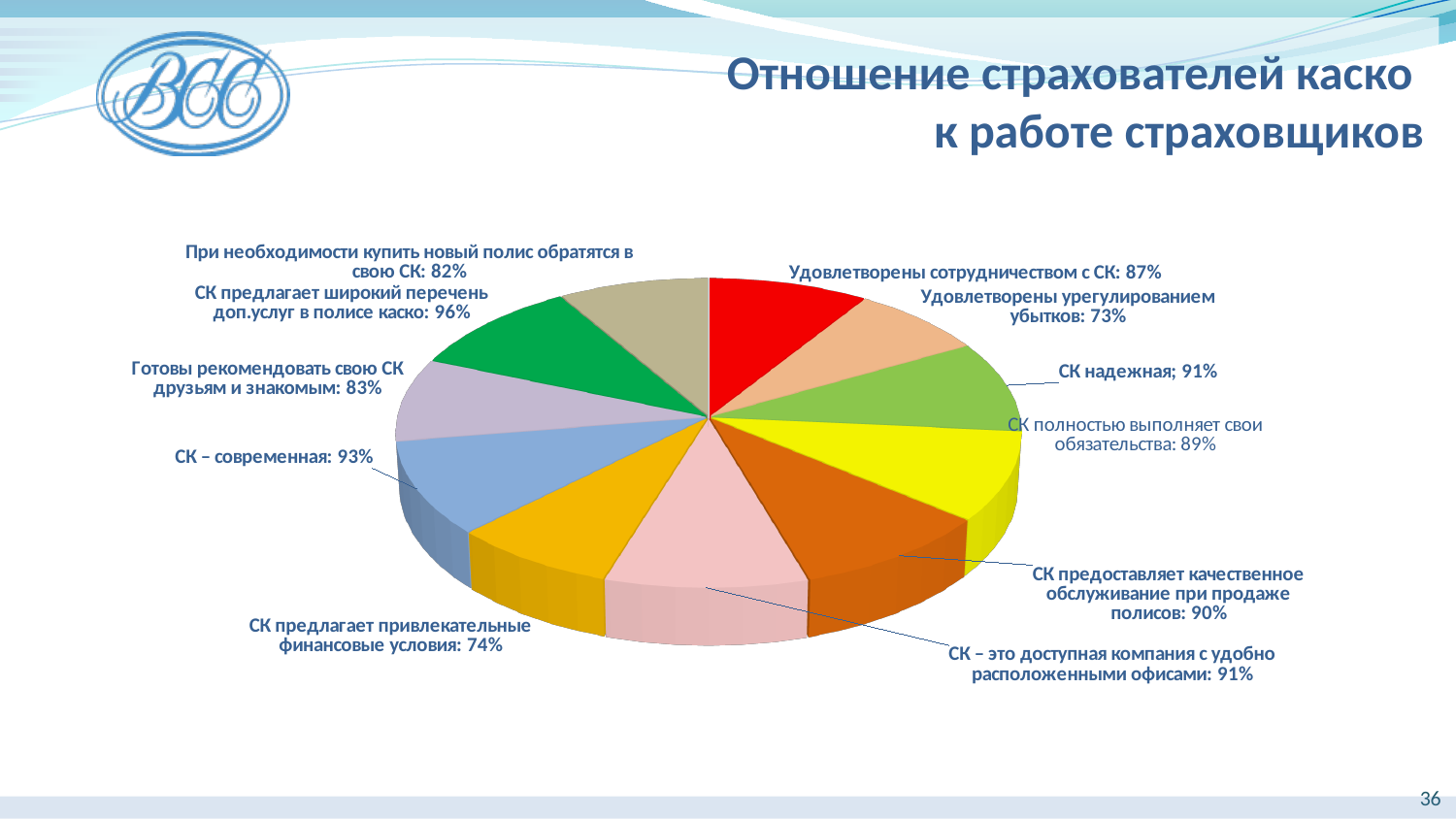
What type of chart is shown on the slide? pie chart What is the value for "Удовлетворены сотрудничеством с СК"? 87% What is the value for "Готовы рекомендовать свою СК друзьям и знакомым"? 83% Which category has the highest value? СК предлагает широкий перечень доп.услуг в полисе каско What is the value for "СК – современная"? 93% What is the difference between the values for "СК надежная" and "Удовлетворены урегулированием убытков"? 18% Which category has the lowest value? Удовлетворены урегулированием убытков What is the title of the slide containing the chart? Отношение страхователей каско к работе страховщиков What is the value for "СК полностью выполняет свои обязательства"? 89% How many slices does the pie chart have? 11 What is the value for "СК предлагает привлекательные финансовые условия"? 74% Which is larger: the value for "СК предоставляет качественное обслуживание при продаже полисов" or for "При необходимости купить новый полис обратятся в свою СК"? СК предоставляет качественное обслуживание при продаже полисов